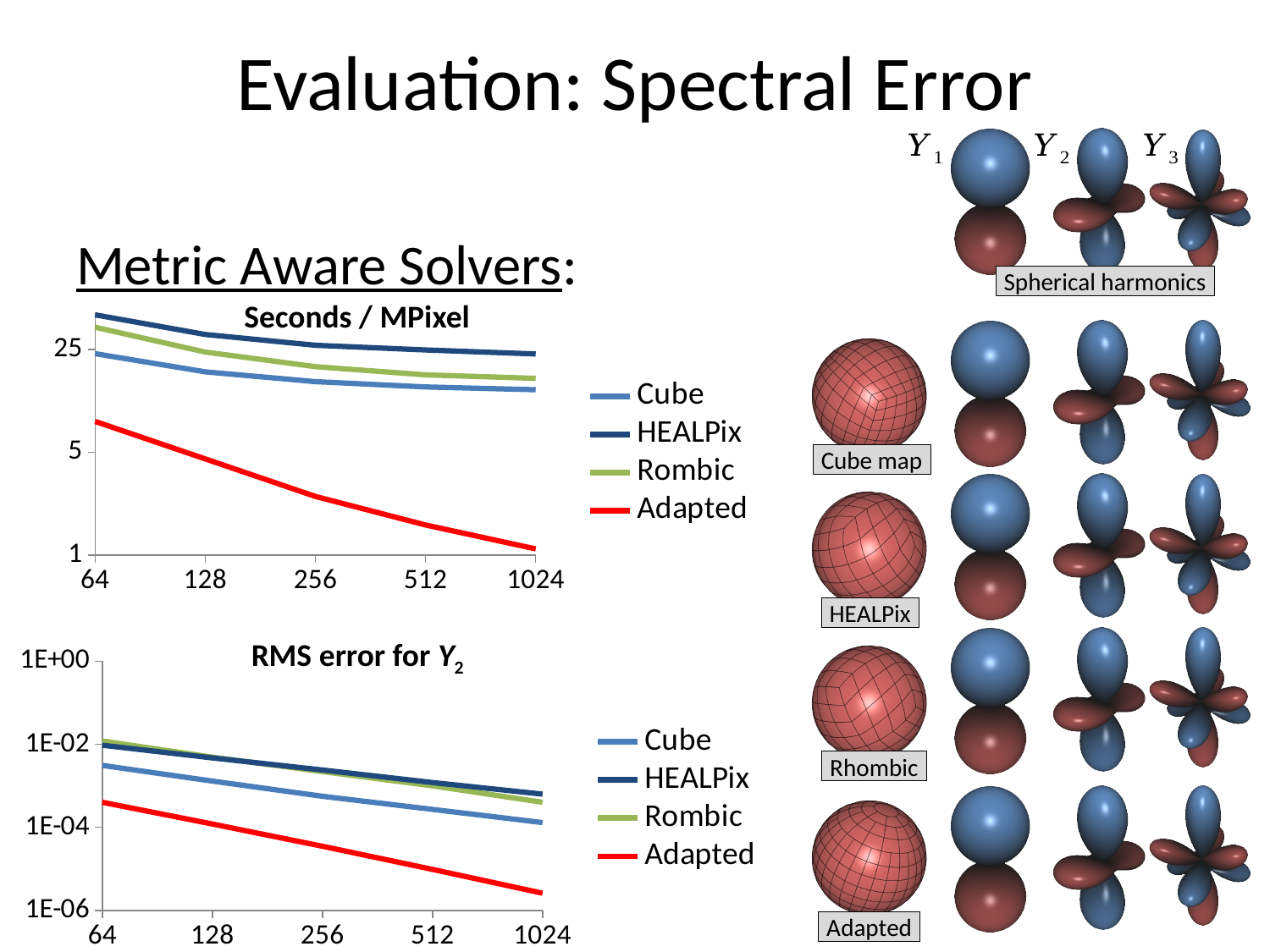
How many x-axis points are plotted in the "RMS error for Y2" chart? 5 In the "Seconds / MPixel" chart, is the value for Cube at 1024 greater or less than 25? less How many series does the legend of the "Seconds / MPixel" chart list? 4 In the "Seconds / MPixel" chart, which series has the highest values across the x axis? HEALPix In the "RMS error for Y2" chart, is the value for Adapted at 1024 greater or less than 1E-04? less In the "Seconds / MPixel" chart, which series has the lowest values across the x axis? Adapted In the "RMS error for Y2" chart, which series has the lowest values across the x axis? Adapted In the "Seconds / MPixel" chart, is the value for Adapted at 64 greater or less than 5? greater In the "RMS error for Y2" chart, which is larger at 64: the value for HEALPix or the value for Adapted? HEALPix In the "Seconds / MPixel" chart, do the values for Adapted rise or fall as the x axis goes from 64 to 1024? fall What colour is the Adapted series line in the "Seconds / MPixel" chart? red What kind of chart is the "Seconds / MPixel" chart? line chart